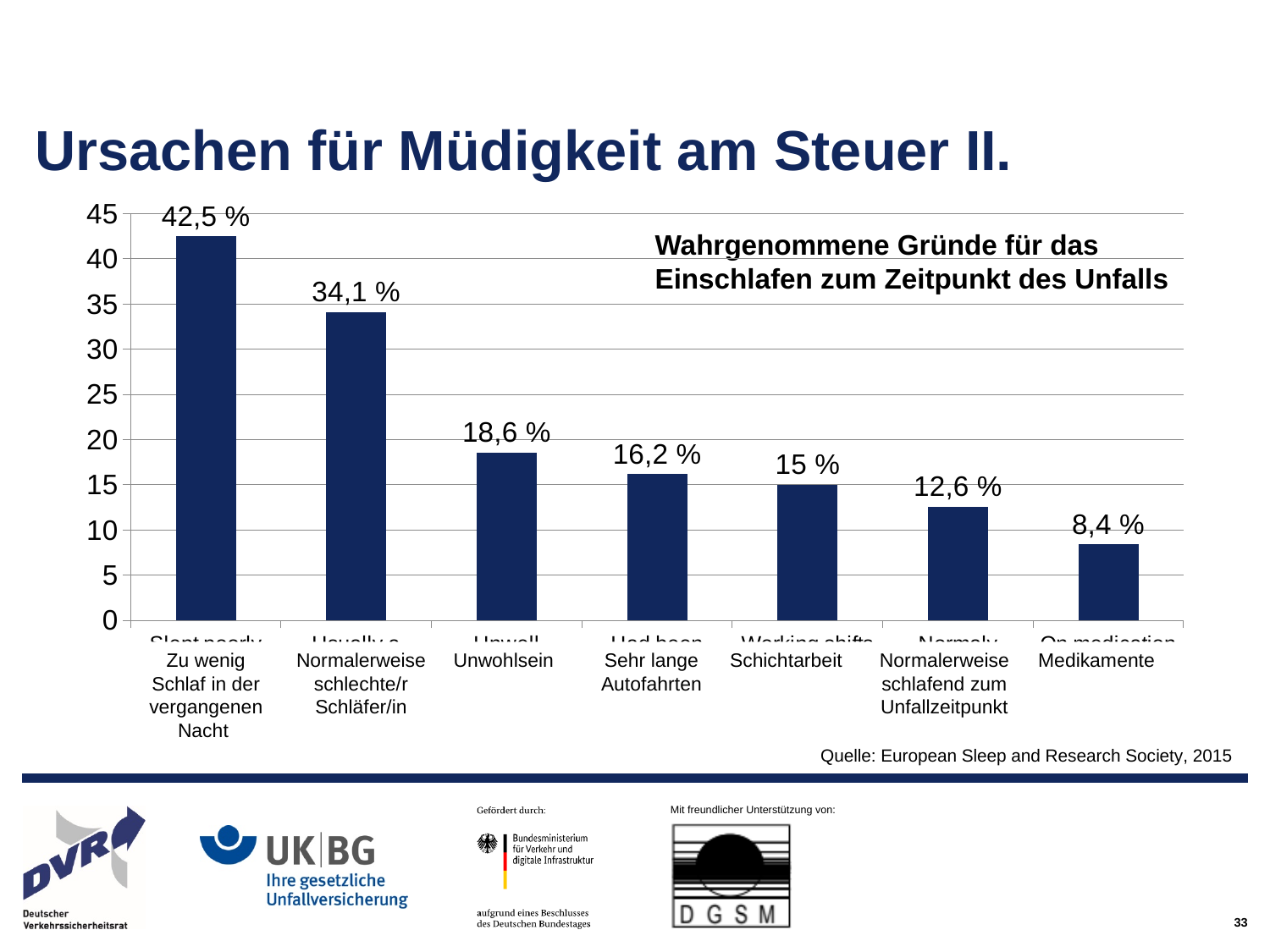
What is the difference between the values for "Unwohlsein" and "Sehr lange Autofahrten"? 2,4 % Which is larger, the value for "Schichtarbeit" or the value for "Normalerweise schlafend zum Unfallzeitpunkt"? Schichtarbeit What is the difference between the values for "Zu wenig Schlaf in der vergangenen Nacht" and "Normalerweise schlechte/r Schläfer/in"? 8,4 % How many categories are shown in the chart? 7 What is the value for "Medikamente"? 8,4 % What kind of chart is shown on the slide? bar chart Which category has the highest value? Zu wenig Schlaf in der vergangenen Nacht What is the value for "Sehr lange Autofahrten"? 16,2 % Which category has the lowest value? Medikamente What is the value for "Zu wenig Schlaf in der vergangenen Nacht"? 42,5 % What is the value for "Schichtarbeit"? 15 % What is the title printed inside the chart area? Wahrgenommene Gründe für das Einschlafen zum Zeitpunkt des Unfalls